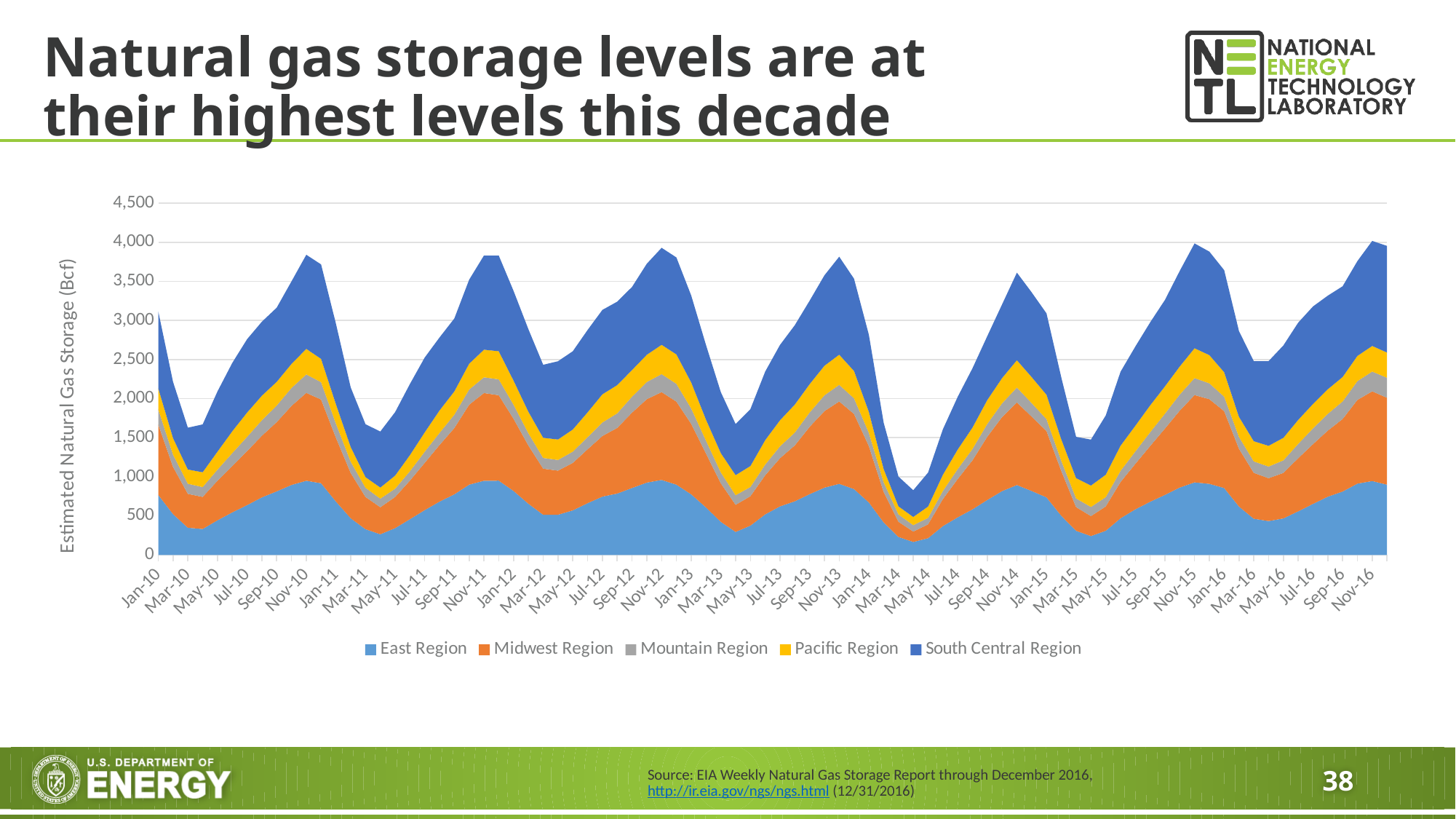
Is the total stacked storage value at Mar-15 greater or less than 2,000? less Does the total stacked storage rise or fall from Mar-14 to Nov-14? Rise Is the total stacked storage value at Nov-10 greater or less than 3,500? greater Does the total stacked storage rise or fall from Nov-15 to Mar-16? Fall What is the label of the vertical axis? Estimated Natural Gas Storage (Bcf) How many series does the legend list? 5 Is the total stacked storage value at Nov-12 greater or less than 3,500? greater What kind of chart is shown on the slide? Area chart Which has the larger total stacked storage, Mar-14 or Mar-15? Mar-15 Which series is plotted as the bottom layer of the stacked area chart? East Region